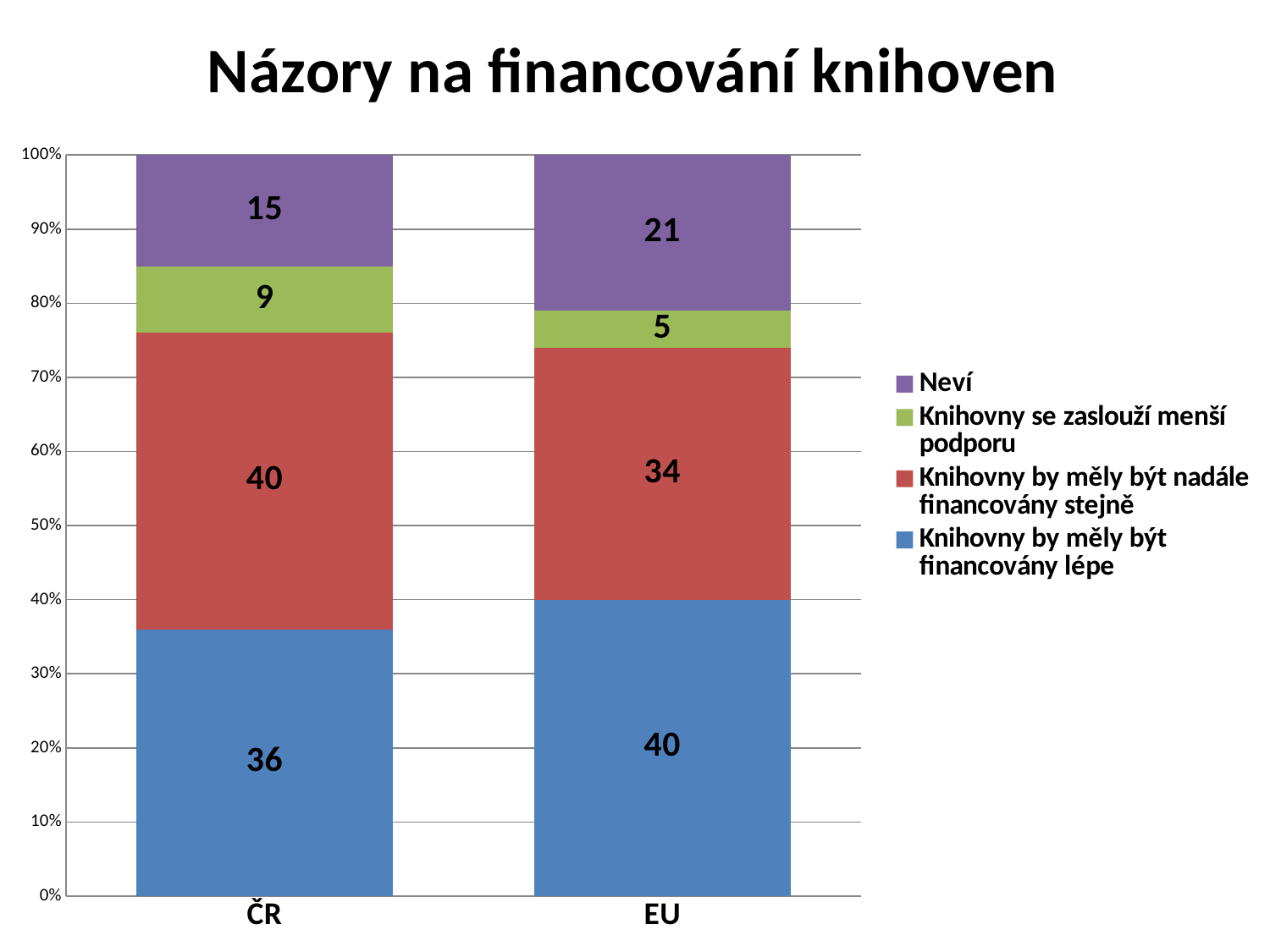
Which series has the largest value in the ČR bar? Knihovny by měly být nadále financovány stejně How many categories are shown on the x axis? 2 What is the value for 'Neví' for EU? 21 Which category has the higher value for 'Neví', ČR or EU? EU What is the difference between the 'Knihovny by měly být nadále financovány stejně' values for ČR and EU? 6 What is the value for 'Knihovny by měly být financovány lépe' for ČR? 36 What is the difference between the 'Knihovny se zaslouží menší podporu' values for ČR and EU? 4 What kind of chart is shown on the slide? Stacked bar chart What is the value for 'Knihovny by měly být nadále financovány stejně' for EU? 34 How many series does the legend list? 4 Which series has the smallest value in the EU bar? Knihovny se zaslouží menší podporu What is the value for 'Knihovny se zaslouží menší podporu' for ČR? 9